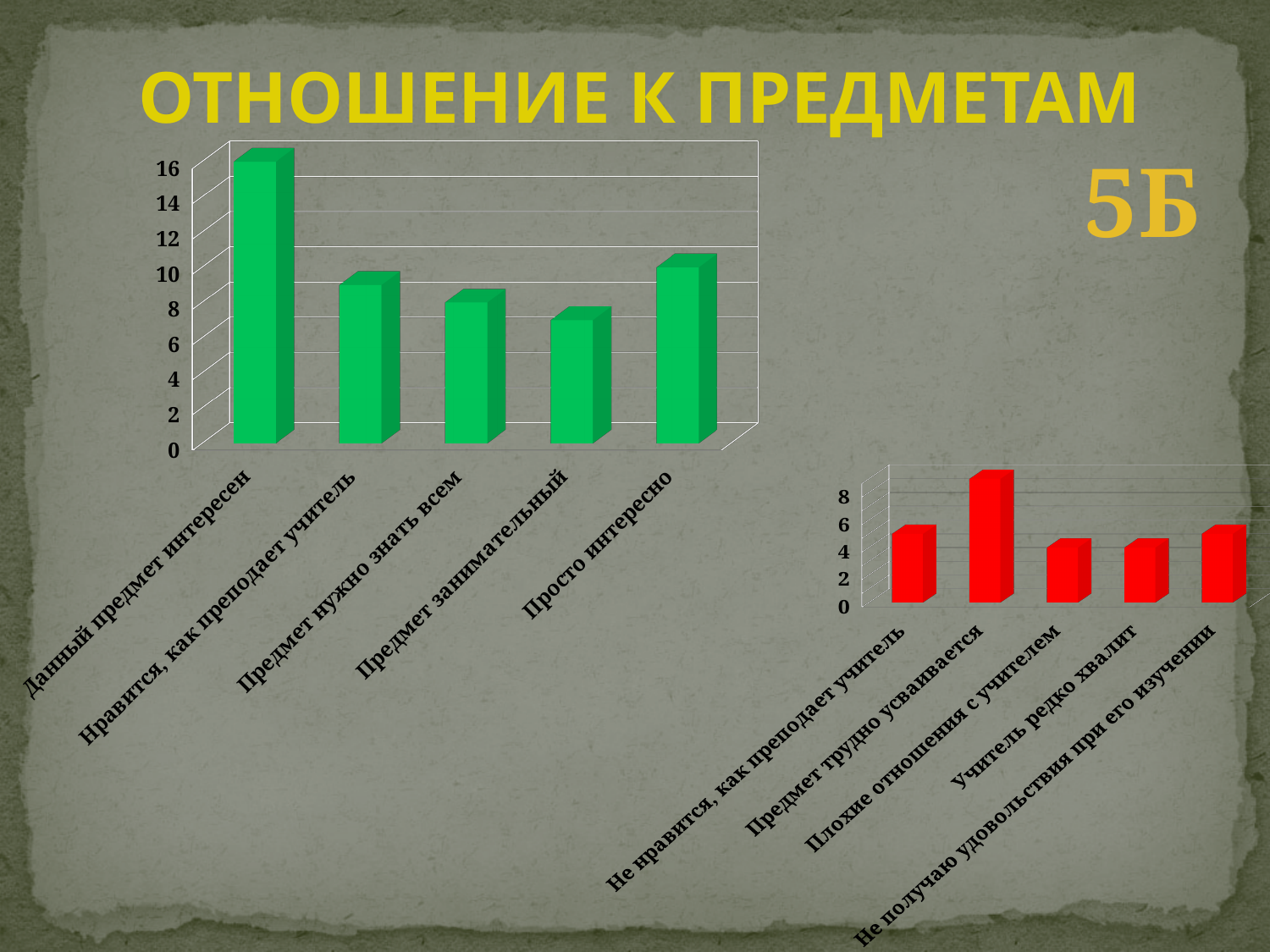
In the red chart at the bottom right, how many categories are shown? 5 What kind of chart is the green chart at the top left of the slide? bar chart In the green chart at the top left, is the value for 'Данный предмет интересен' greater or less than 14? greater In the red chart at the bottom right, which category has the highest value? Предмет трудно усваивается In the green chart at the top left, which is larger: the value for 'Данный предмет интересен' or the value for 'Просто интересно'? Данный предмет интересен In the red chart at the bottom right, is the value for 'Предмет трудно усваивается' greater or less than 6? greater In the green chart at the top left, is the value for 'Предмет занимательный' greater or less than 10? less In the green chart at the top left, which category has the highest value? Данный предмет интересен In the red chart at the bottom right, which is larger: the value for 'Предмет трудно усваивается' or the value for 'Учитель редко хвалит'? Предмет трудно усваивается In the green chart at the top left, how many categories are shown? 5 In the green chart at the top left, which category has the lowest value? Предмет занимательный What kind of chart is the red chart at the bottom right of the slide? bar chart